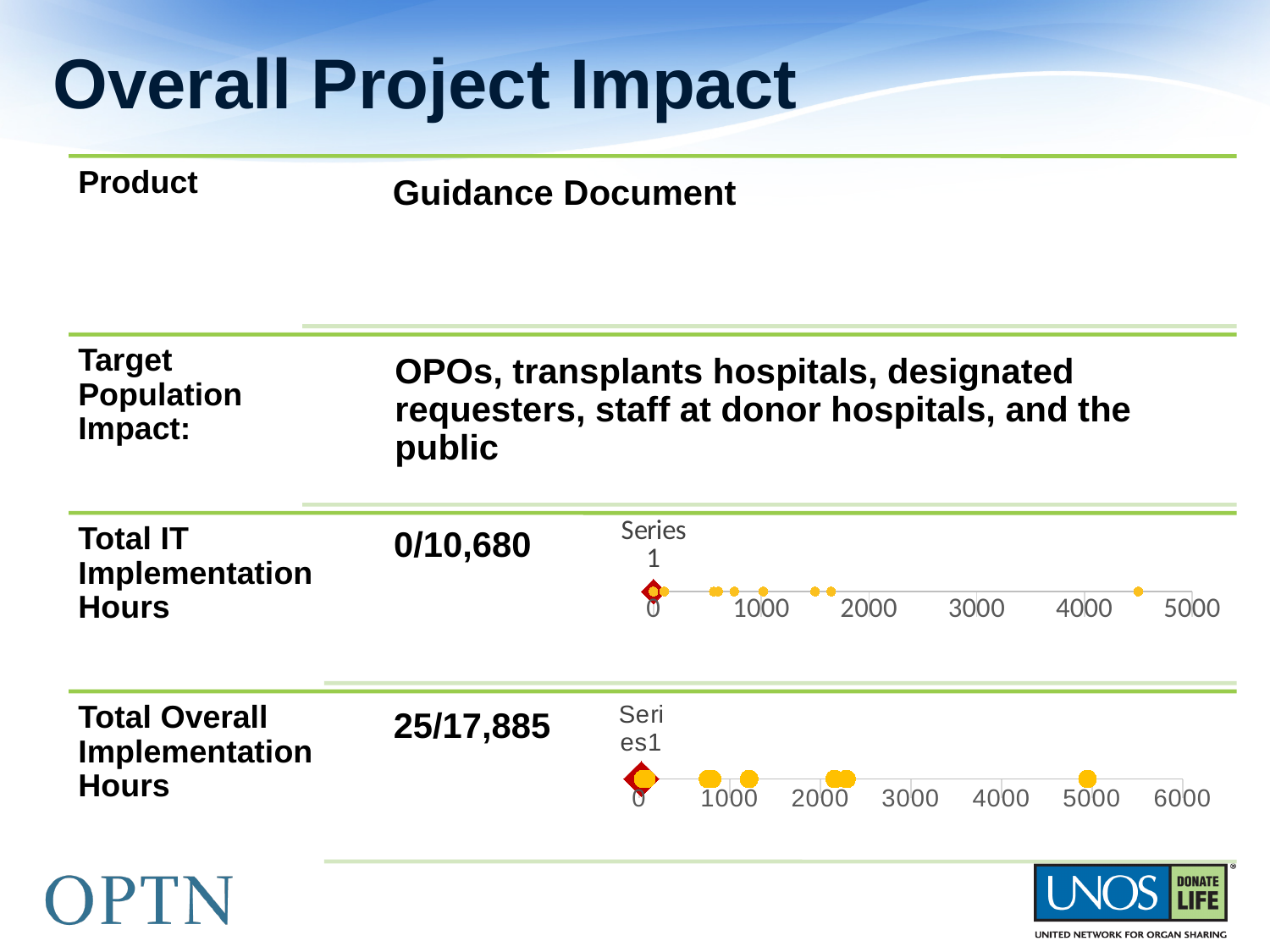
In the chart next to "Total IT Implementation Hours", is the rightmost point greater or less than 4000? greater In the chart next to "Total IT Implementation Hours", is the red diamond marker greater or less than 1000? less In the chart next to "Total Overall Implementation Hours", is the rightmost point greater or less than 4000? greater In the chart next to "Total IT Implementation Hours", what is the highest value labelled on the horizontal axis? 5000 What kind of chart is shown next to "Total IT Implementation Hours"? scatter chart What kind of chart is shown next to "Total Overall Implementation Hours"? scatter chart